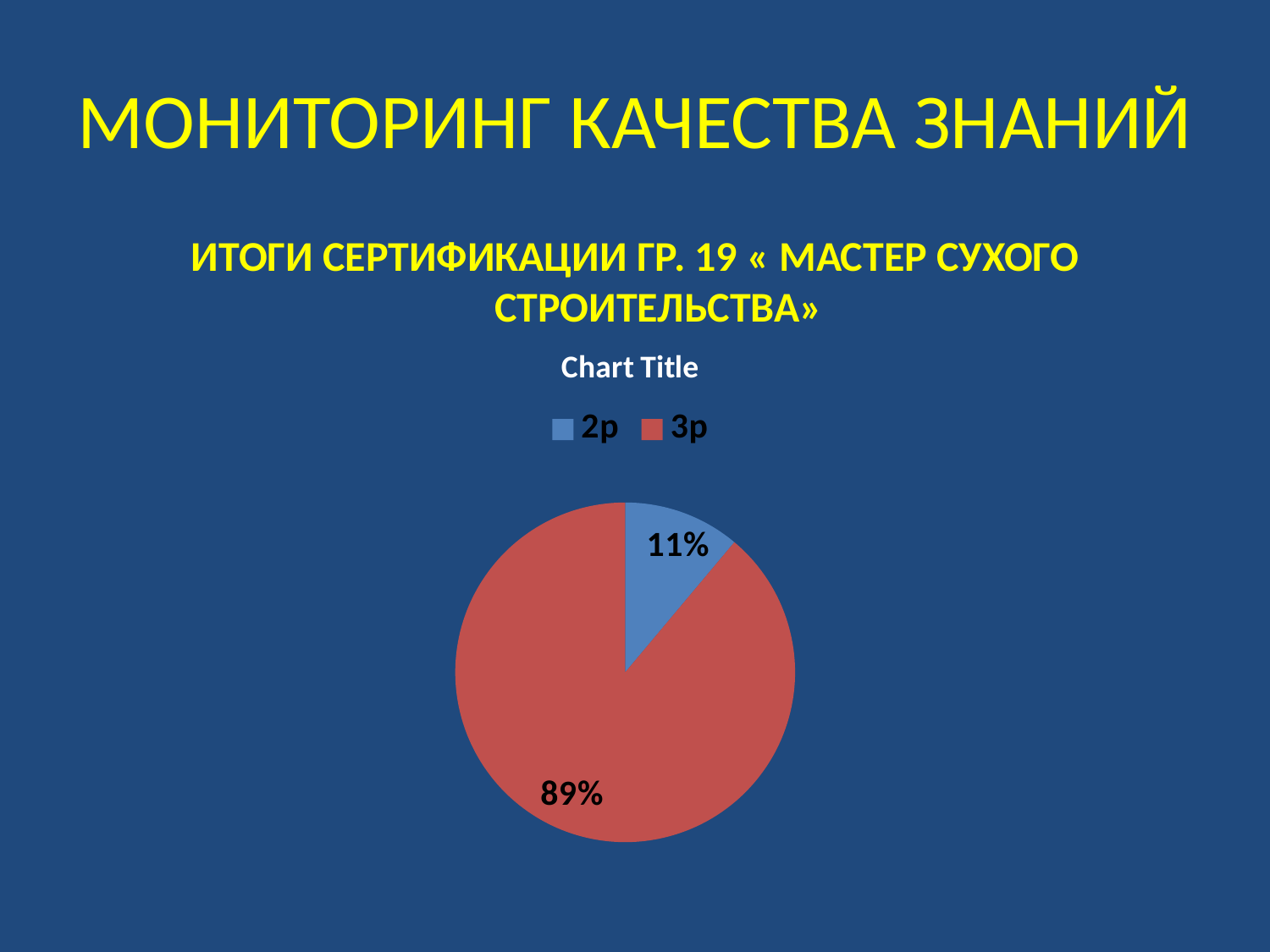
How many slices does the pie chart have? 2 Which category has the smallest slice of the pie? 2р What colour is the 3р slice in the pie chart? red How many entries does the legend list? 2 Which category has the largest slice of the pie? 3р What kind of chart is shown on the slide? pie chart What is the title shown above the pie chart? Chart Title What is the difference in percentage points between the 3р slice and the 2р slice? 78% Which slice is larger, 2р or 3р? 3р What share of the pie does the 2р slice represent? 11% What share of the pie does the 3р slice represent? 89%